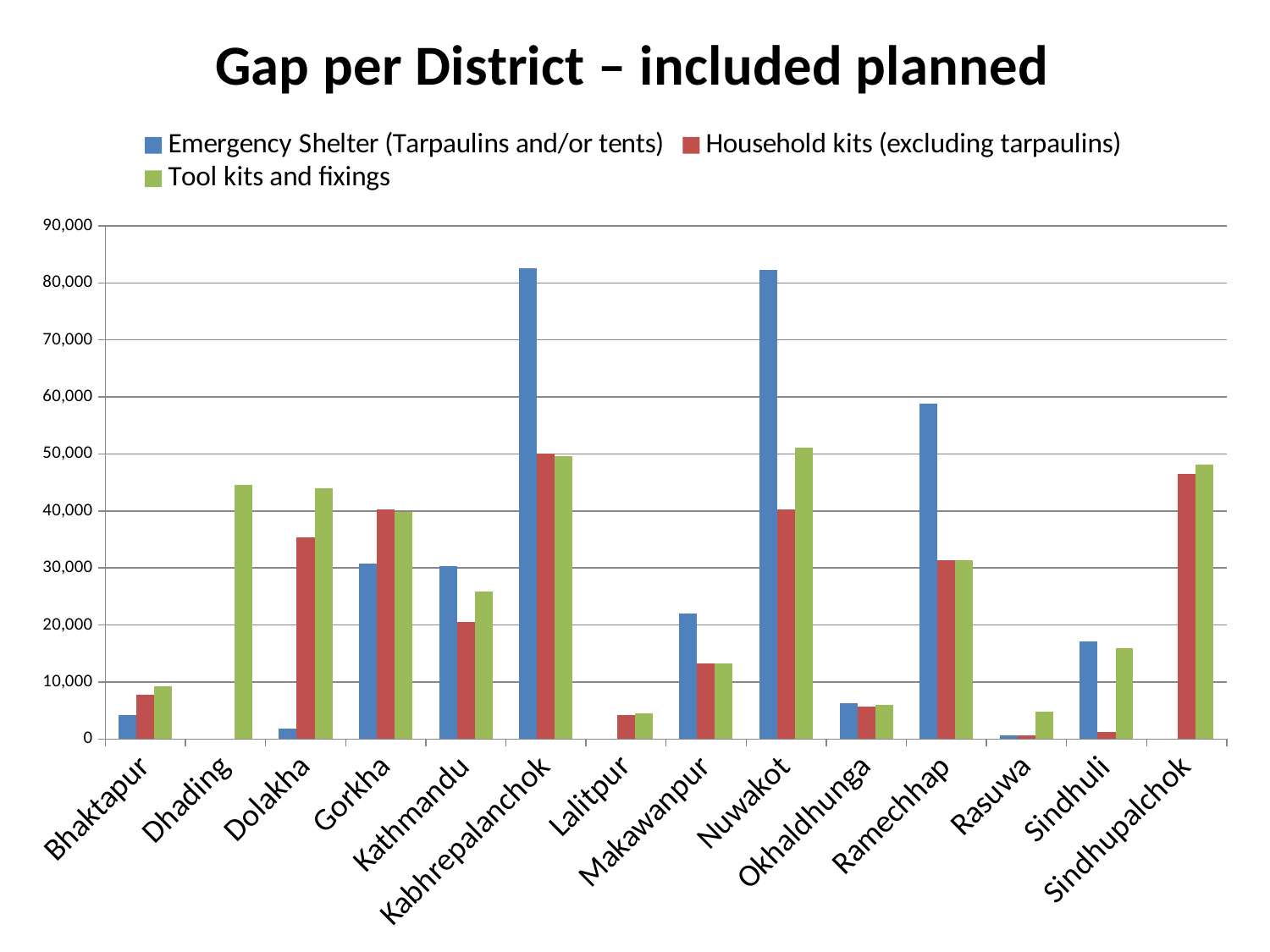
How many districts are shown along the x axis? 14 How many series does the legend list? 3 For Dolakha, which is larger: Household kits (excluding tarpaulins) or Tool kits and fixings? Tool kits and fixings Is the Tool kits and fixings value for Dhading greater or less than 40,000? greater What is the title of the chart? Gap per District – included planned What kind of chart is shown on the slide? bar chart Is the Emergency Shelter (Tarpaulins and/or tents) value for Sindhuli greater or less than 20,000? less Is the Emergency Shelter (Tarpaulins and/or tents) value for Ramechhap greater or less than 50,000? greater For Kathmandu, which is larger: Emergency Shelter (Tarpaulins and/or tents) or Household kits (excluding tarpaulins)? Emergency Shelter (Tarpaulins and/or tents)